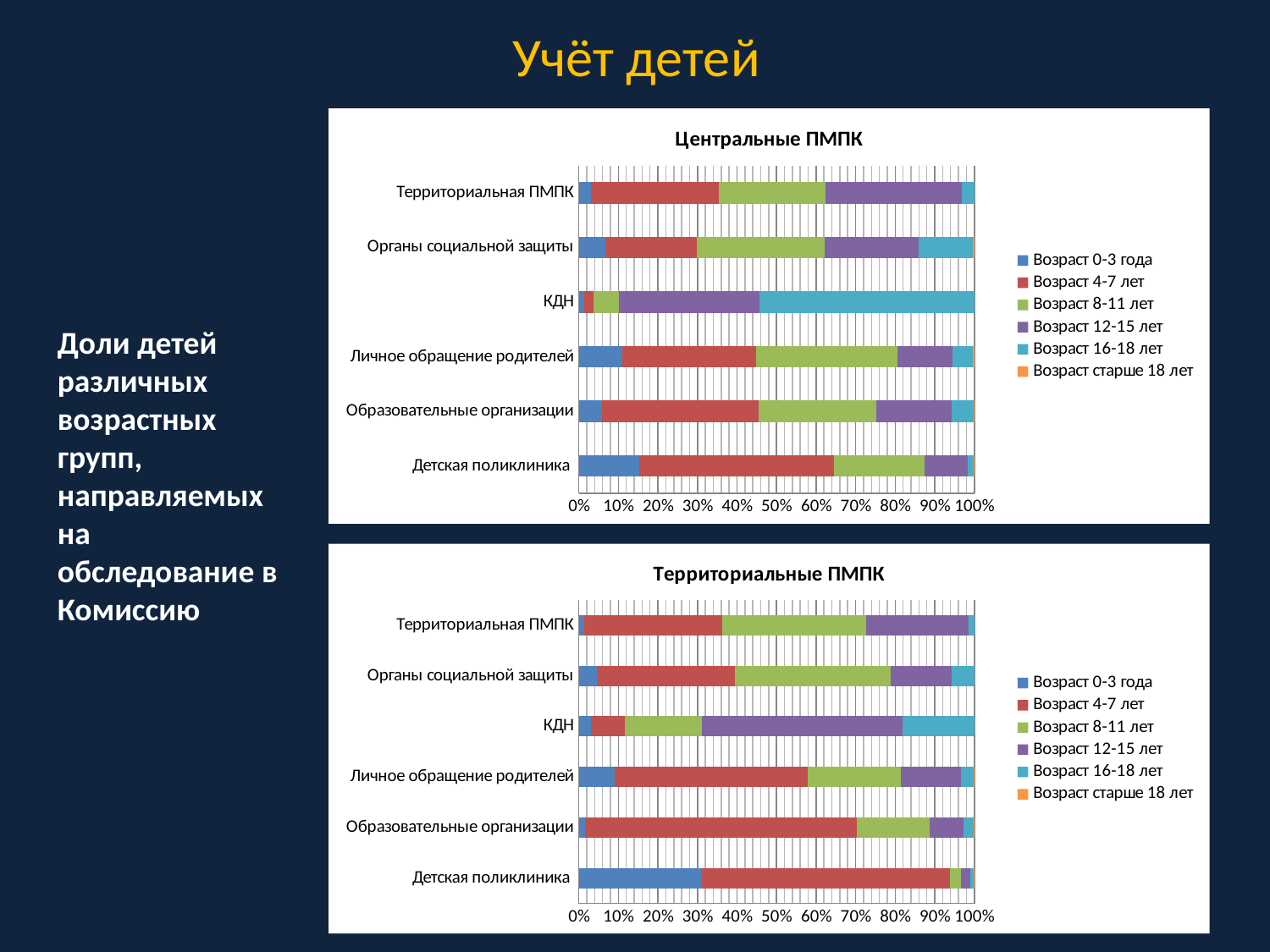
How many categories are shown on the y axis of the "Территориальные ПМПК" chart? 6 In the "Территориальные ПМПК" chart, which has the larger "Возраст 4-7 лет" share: Образовательные организации or Органы социальной защиты? Образовательные организации How many series does the legend of the "Центральные ПМПК" chart list? 6 In the "Центральные ПМПК" chart, what does each stacked bar total on the x axis? 100% What is the title of the lower chart on the slide? Территориальные ПМПК In the "Территориальные ПМПК" chart, is the "Возраст 4-7 лет" share for Образовательные организации greater or less than 60%? greater In the "Центральные ПМПК" chart, is the "Возраст 16-18 лет" share for КДН greater or less than 40%? greater In the "Территориальные ПМПК" chart, which category has the largest share for "Возраст 0-3 года"? Детская поликлиника What kind of chart is the "Центральные ПМПК" chart? Stacked bar chart In the "Центральные ПМПК" chart, which category has the largest share for "Возраст 16-18 лет"? КДН In the "Центральные ПМПК" chart, which legend entry is shown in orange? Возраст старше 18 лет In the "Территориальные ПМПК" chart, is the "Возраст 0-3 года" share for Детская поликлиника greater or less than 20%? greater